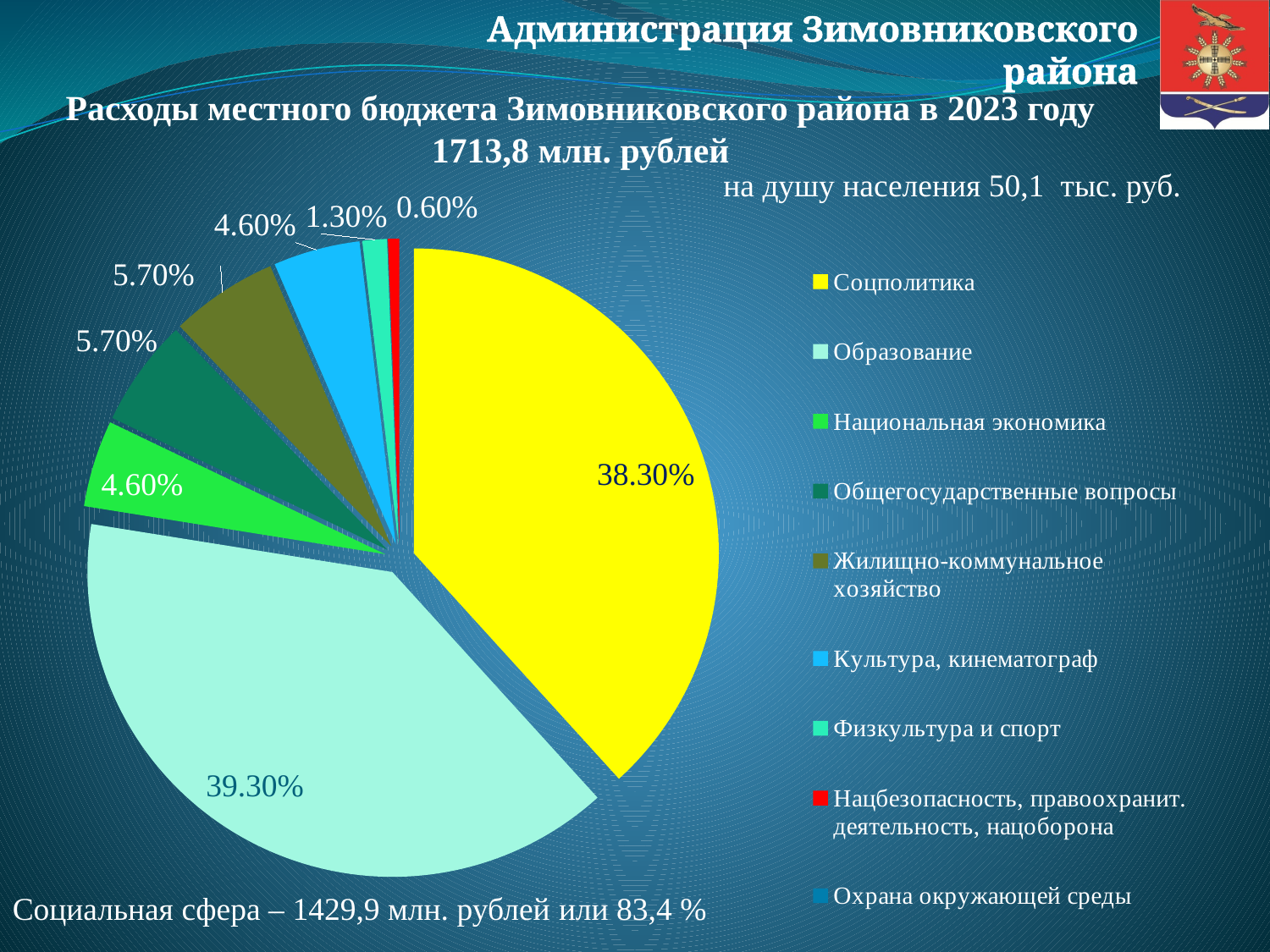
What share of the pie does Образование have? 39.30% What kind of chart is shown on the slide? pie chart How many entries does the legend list? 9 What is the difference between the shares of Образование and Соцполитика? 1.00% Which is larger, the share for Образование or the share for Соцполитика? Образование Which category has the largest share of the pie? Образование What is the value shown for Нацбезопасность, правоохранит. деятельность, нацоборона? 0.60% What is the value shown for Национальная экономика? 4.60% What colour is the slice for Соцполитика? yellow What share of the pie does Соцполитика have? 38.30% What is the value shown for Общегосударственные вопросы? 5.70% What is the value shown for Физкультура и спорт? 1.30%